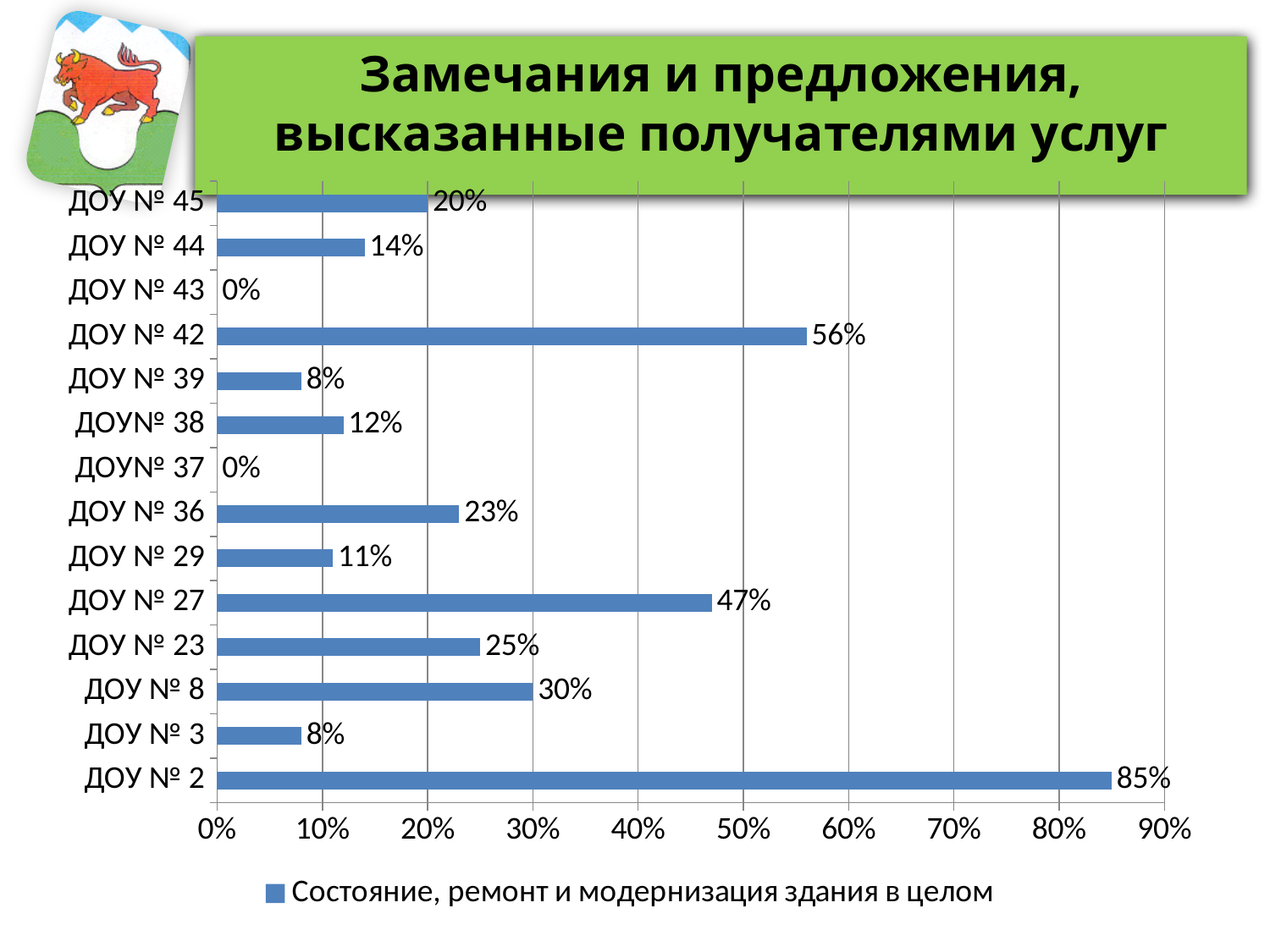
What is the value for ДОУ № 36? 23% What is the value for ДОУ № 42? 56% What kind of chart is shown on the slide? bar chart Is the value for ДОУ № 27 greater or less than 40%? greater What is the difference between the values for ДОУ № 8 and ДОУ № 23? 5% How many series does the legend list? 1 What is the value for ДОУ № 27? 47% What is the difference between the values for ДОУ № 2 and ДОУ № 42? 29% What is the legend entry for the series shown? Состояние, ремонт и модернизация здания в целом How many categories are shown on the chart? 14 Which category has the highest value? ДОУ № 2 Which is larger, the value for ДОУ № 44 or the value for ДОУ № 45? ДОУ № 45